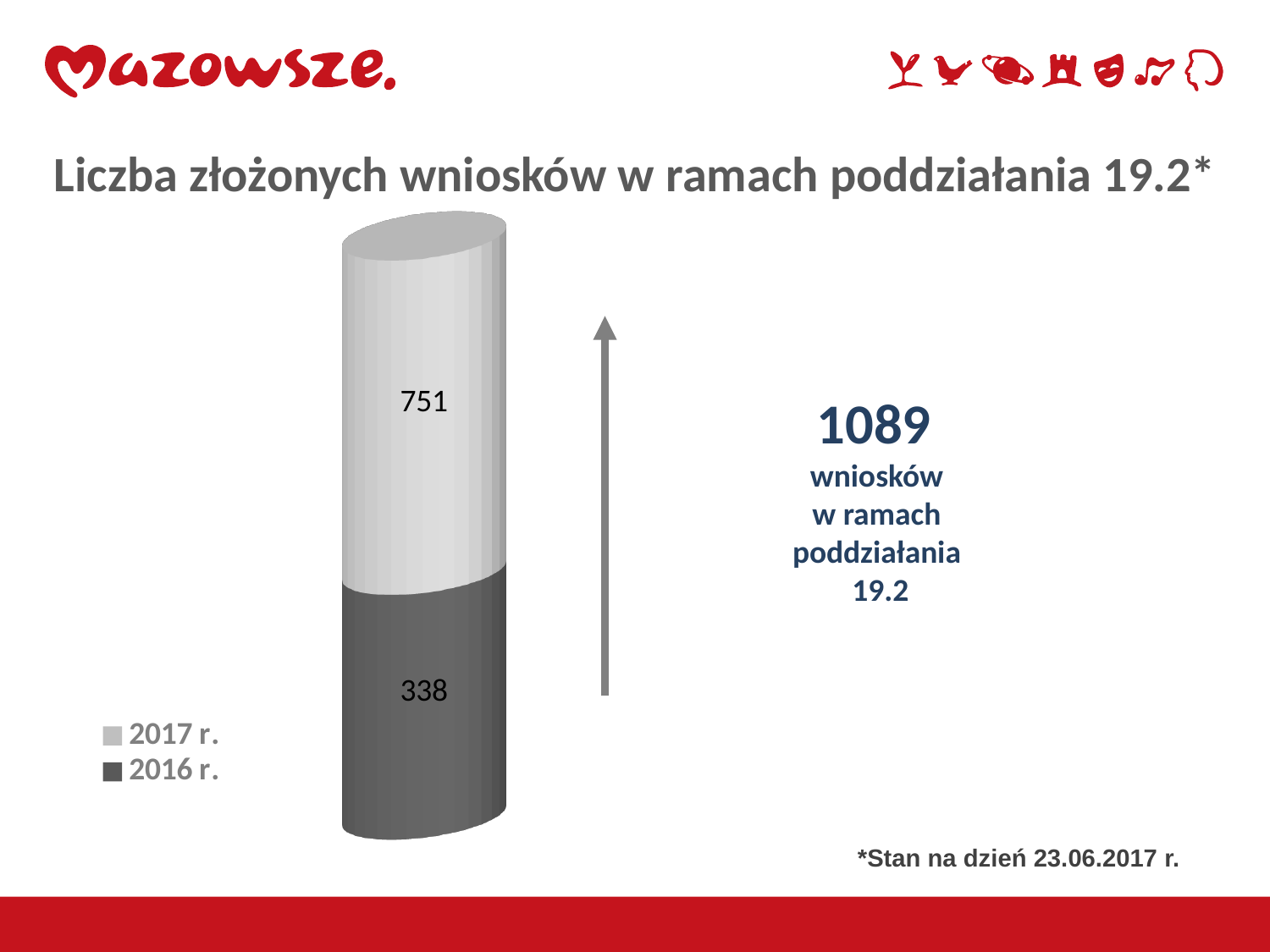
What kind of chart is shown on the slide? Stacked bar chart What is the difference between the 2017 r. value and the 2016 r. value? 413 Which series has the higher value, 2017 r. or 2016 r.? 2017 r. How many bars are plotted in the chart? 1 What is the value for 2016 r. in the stacked bar? 338 How many series does the legend list? 2 Which series has the lowest value in the chart? 2016 r. What is the title of the chart? Liczba złożonych wniosków w ramach poddziałania 19.2* What is the value for 2017 r. in the stacked bar? 751 Which series is shown in the darker grey colour? 2016 r. What is the total of the stacked bar? 1089